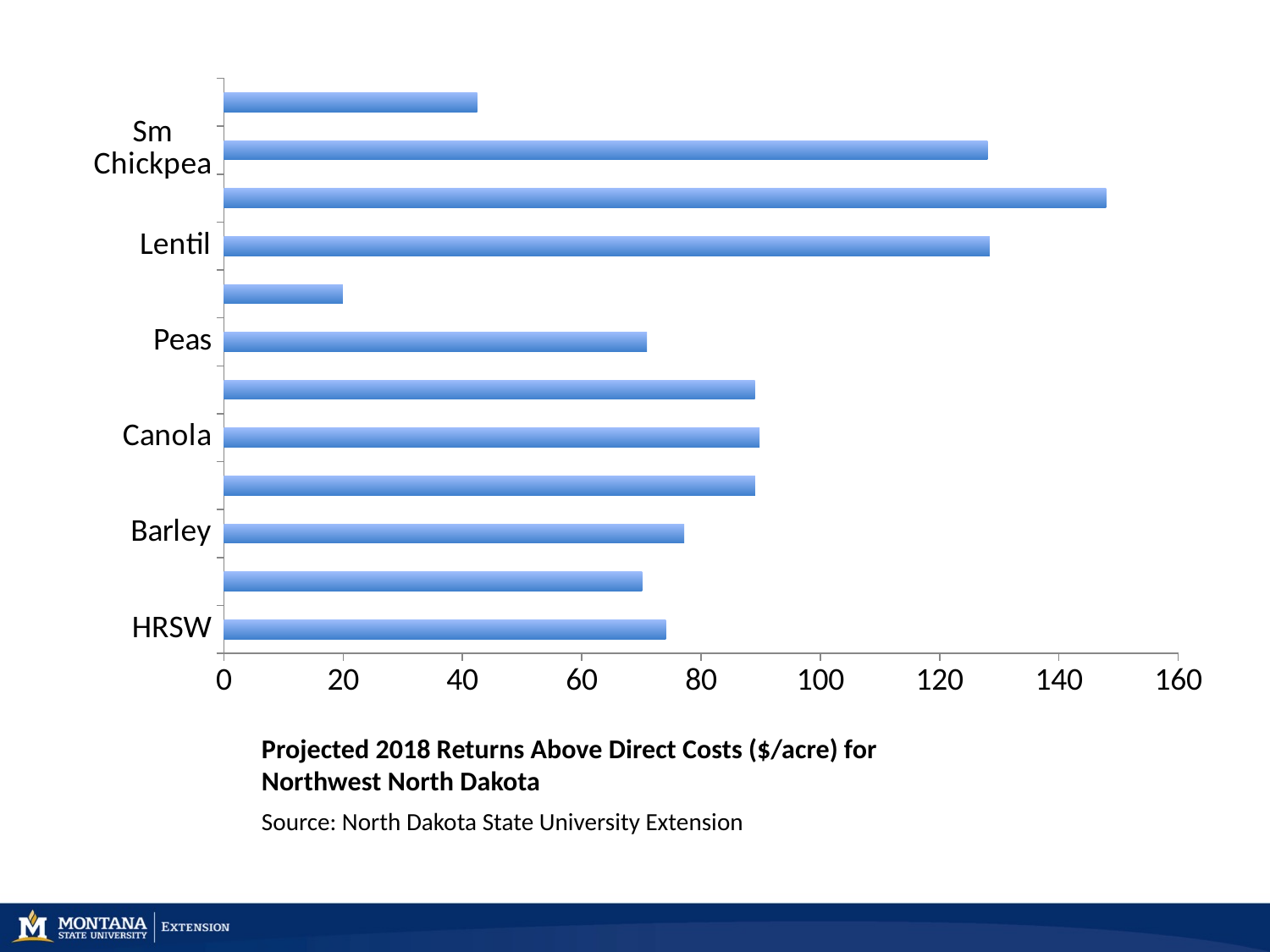
Is the value for Canola greater or less than 80? greater How many category labels are shown on the vertical axis of the chart? 6 Is the value for Sm Chickpea greater or less than 100? greater What is the highest value shown on the horizontal axis of the chart? 160 Is the value for HRSW greater or less than 60? greater What kind of chart is shown on the slide? bar chart Which has the larger value, Canola or HRSW? Canola Which has the larger value, Lentil or Peas? Lentil What is the title of the chart? Projected 2018 Returns Above Direct Costs ($/acre) for Northwest North Dakota How many bars are plotted in the chart? 12